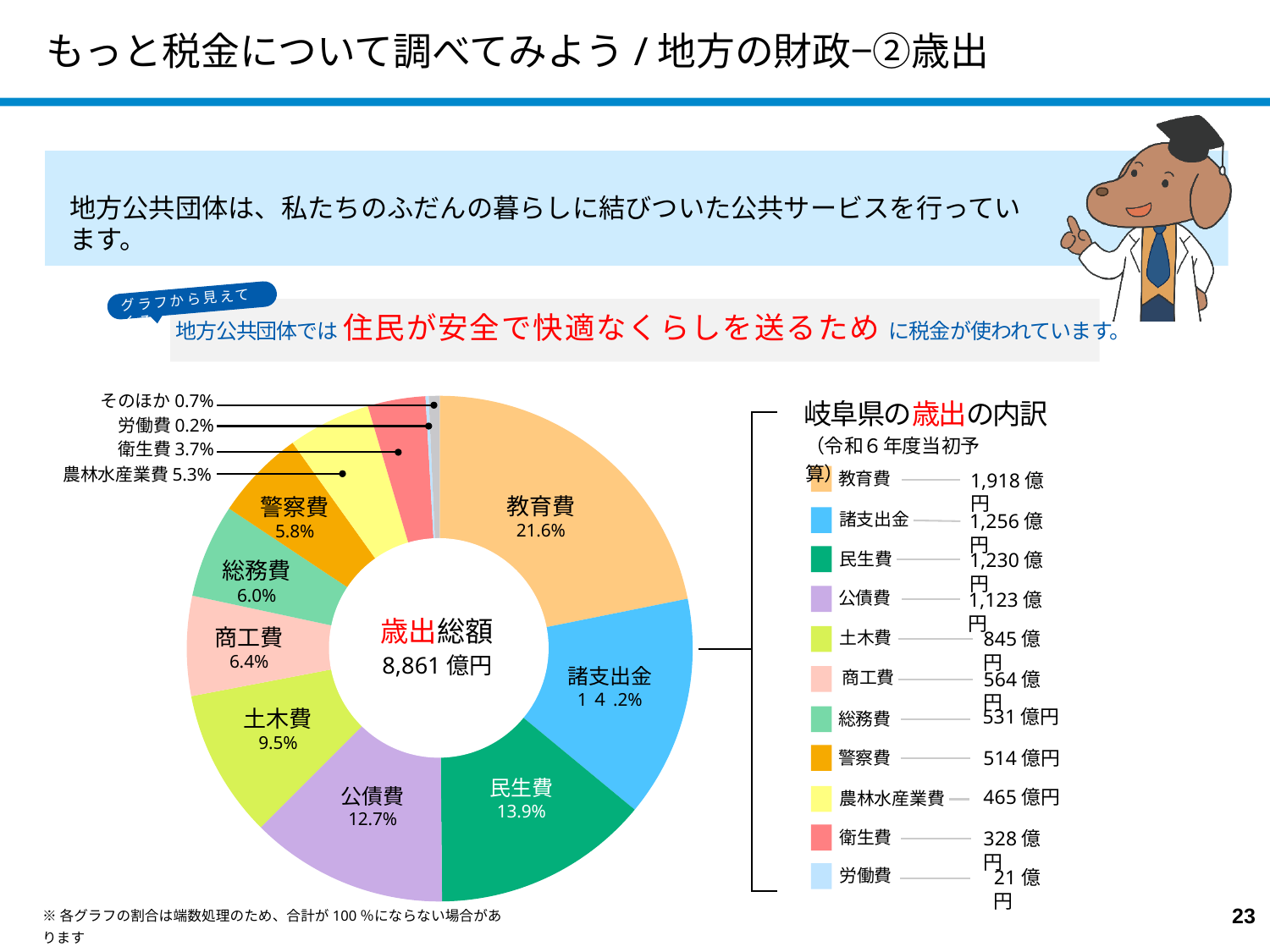
According to the legend, what is the amount for 土木費? 845 億円 Which is larger, the share of 民生費 or the share of 公債費? 民生費 What percentage of the expenditure is 教育費? 21.6% Which category has the smallest share of the expenditure? 労働費 Which category has the largest share of the expenditure? 教育費 What is the difference in amount between 諸支出金 and 民生費 according to the legend? 26 億円 What is the title of the chart shown on the right side of the slide? 岐阜県の歳出の内訳 What is the difference in percentage points between 教育費 and 諸支出金? 7.4 How many categories does the legend on the right list? 11 What percentage of the expenditure is 公債費? 12.7% What type of chart is shown on the slide? Pie chart (donut) What is the total expenditure (歳出総額) shown in the centre of the chart? 8,861 億円